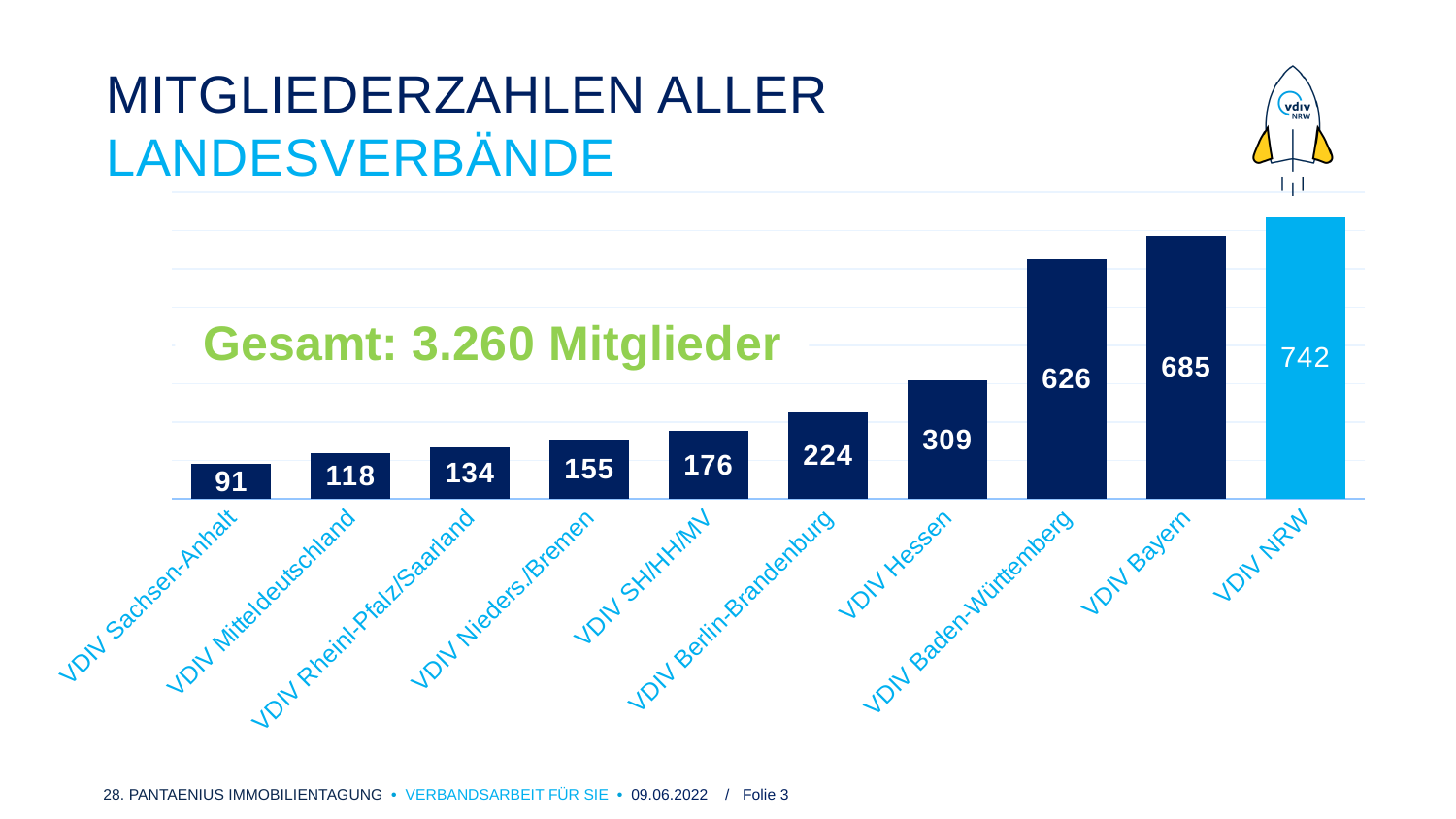
Which category has the highest value? VDIV NRW Do the values rise or fall from left to right along the x axis? rise Which category has the lowest value? VDIV Sachsen-Anhalt How many categories are shown in the chart? 10 What is the difference between the values for VDIV NRW and VDIV Bayern? 57 What total number of members is stated in the green text on the chart? 3.260 Mitglieder Which is larger, the value for VDIV SH/HH/MV or the value for VDIV Mitteldeutschland? VDIV SH/HH/MV What is the value for VDIV Berlin-Brandenburg? 224 What is the value for VDIV Hessen? 309 What is the value for VDIV Sachsen-Anhalt? 91 What is the difference between the values for VDIV Baden-Württemberg and VDIV Hessen? 317 What kind of chart is shown on the slide? bar chart